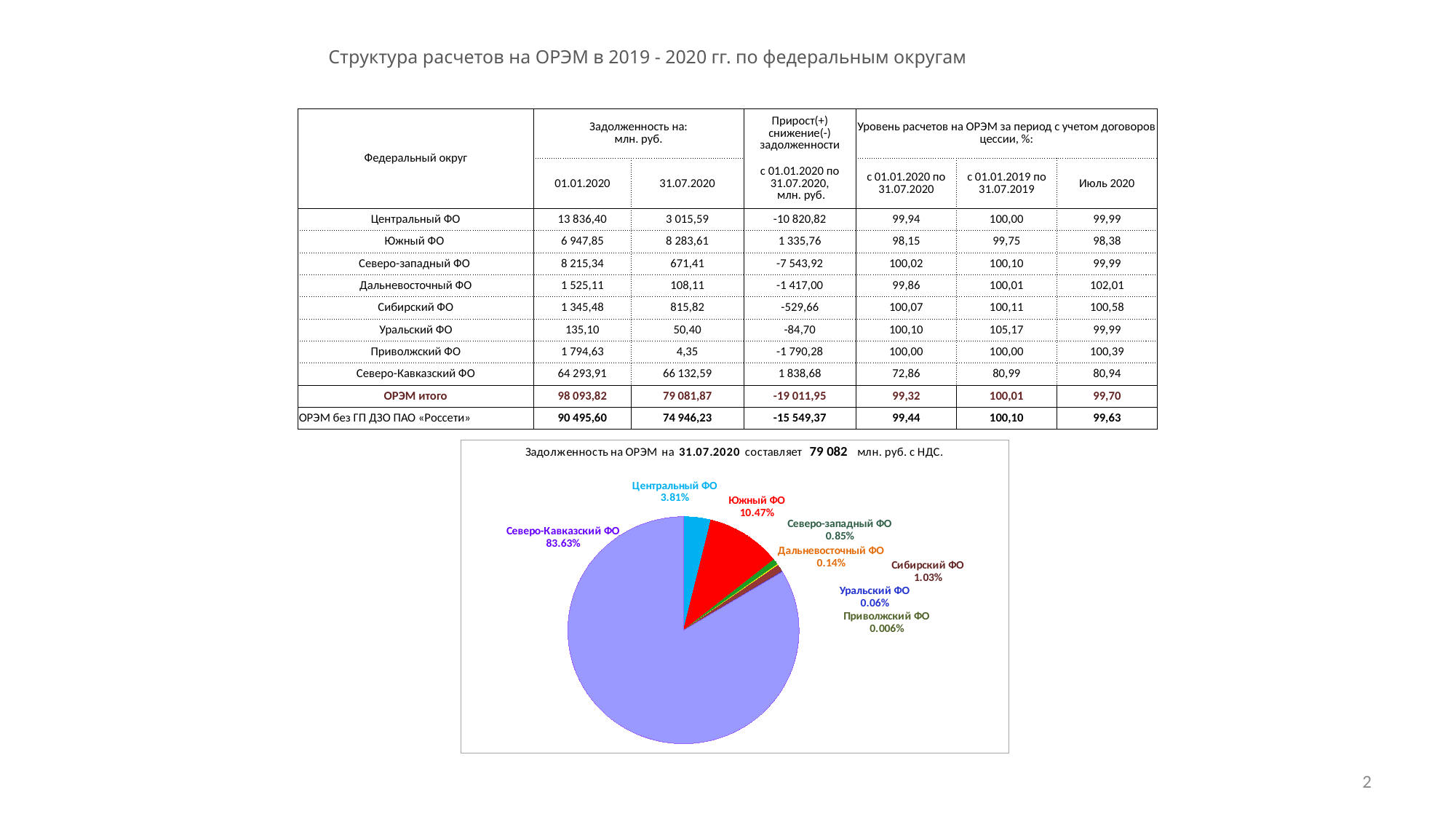
What kind of chart is shown on the slide? pie chart What share of the pie chart does Сибирский ФО hold? 1.03% Which federal district has the largest slice in the pie chart? Северо-Кавказский ФО How many slices does the pie chart have? 8 Which federal district has the smallest slice in the pie chart? Приволжский ФО What share of the pie chart does Приволжский ФО hold? 0.006% What share of the pie chart does Северо-Кавказский ФО hold? 83.63% Which slice is larger in the pie chart, Южный ФО or Центральный ФО? Южный ФО According to the pie chart's title, what is the total debt on ОРЭМ as of 31.07.2020? 79 082 млн. руб. с НДС What is the difference in percentage points between the Южный ФО and Центральный ФО slices? 6.66